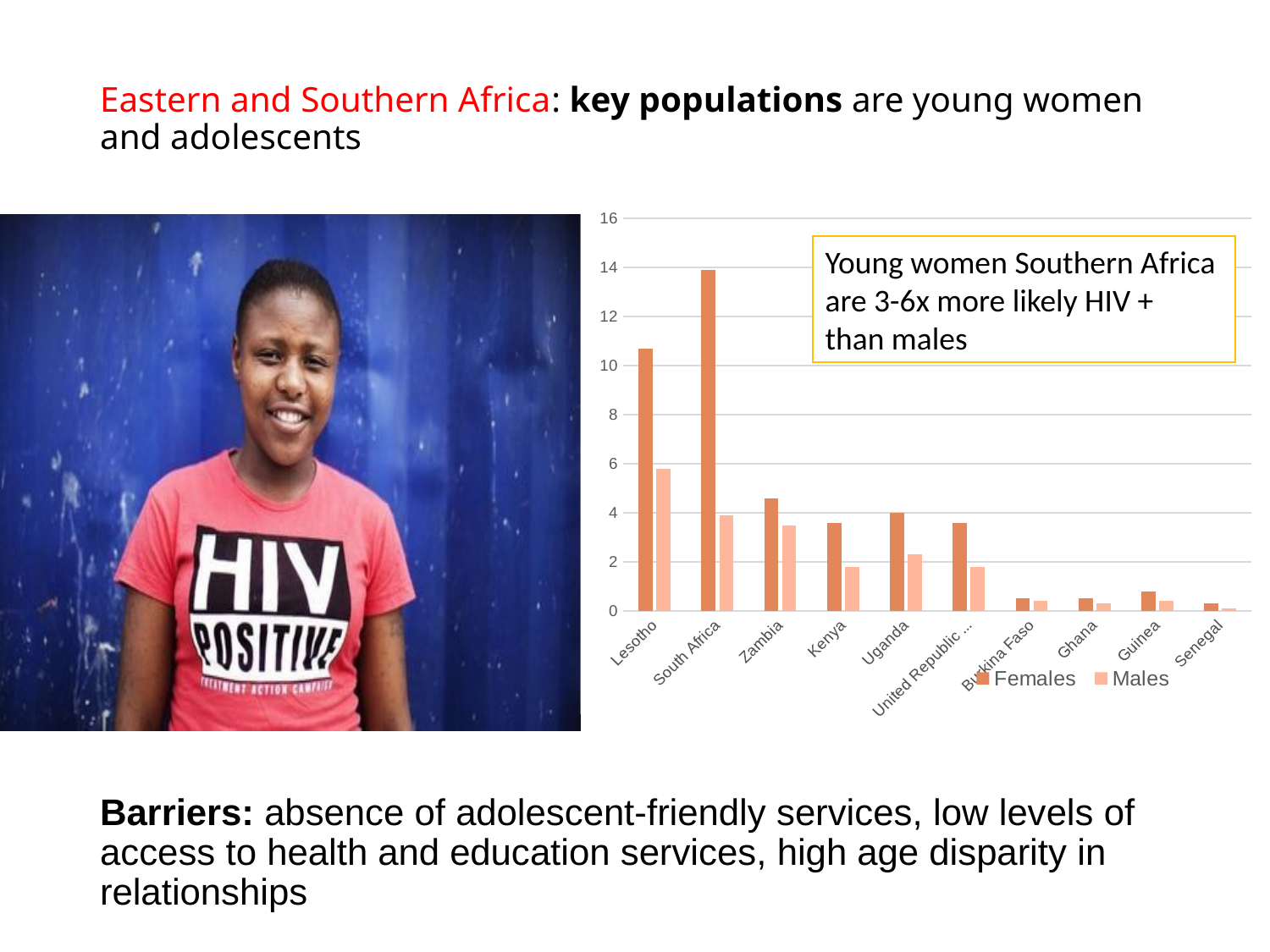
What kind of chart is shown on the slide? bar chart Is the Females value for Senegal greater or less than 2? less How many series does the chart's legend list? 2 What are the two series named in the chart's legend? Females and Males Is the Females value for South Africa greater or less than 12? greater Which country has the highest Males value in the chart? Lesotho How many countries are shown along the x axis of the chart? 10 Which is larger: the Males value for Lesotho or the Males value for South Africa? Lesotho Which country has the highest Females value in the chart? South Africa Is the Females value for Lesotho greater or less than 8? greater Which country has the lowest Males value in the chart? Senegal